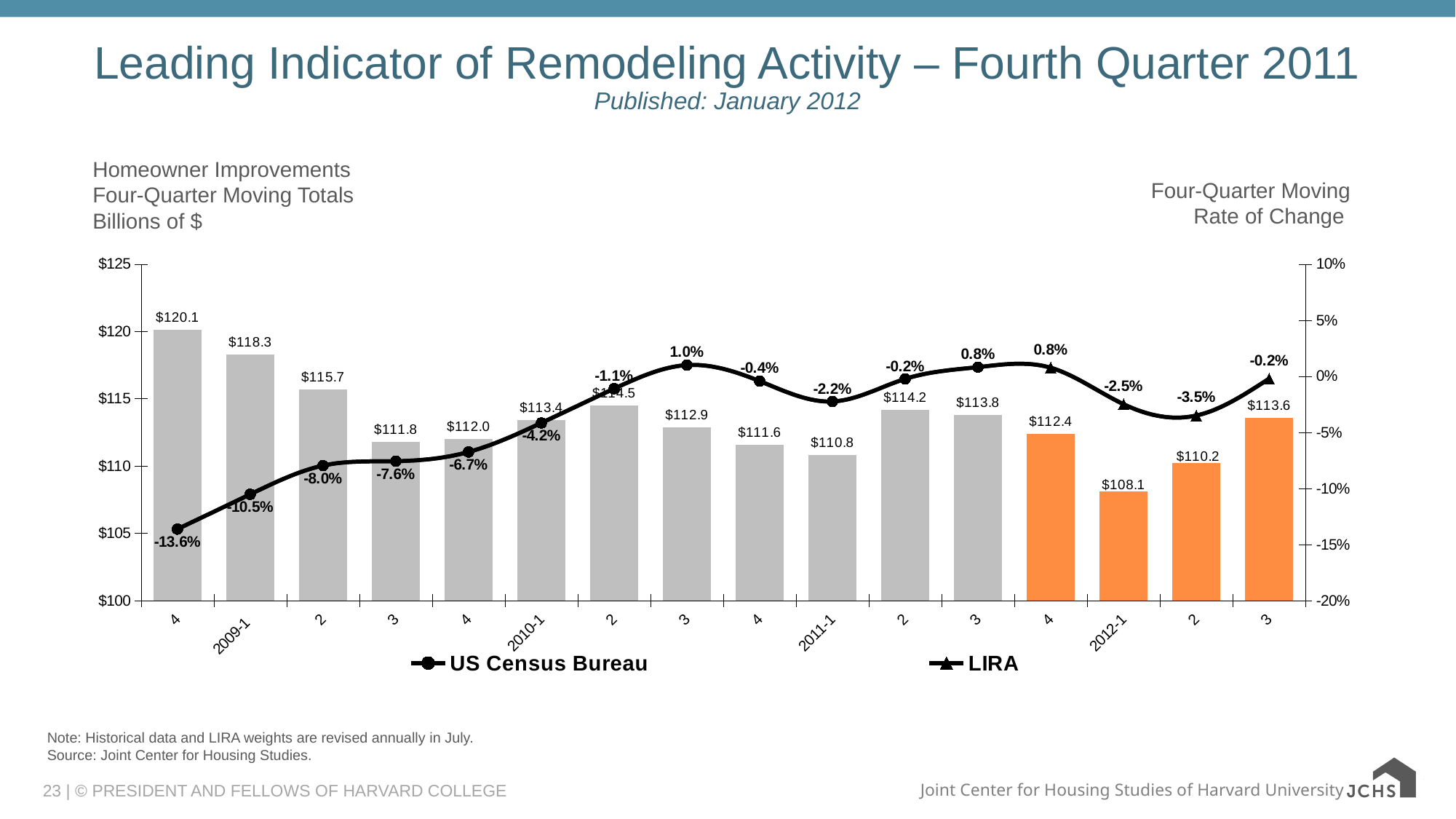
What is the four-quarter moving rate of change for 2011-1? -2.2% What is the four-quarter moving rate of change for the last quarter shown, 2012-3? -0.2% Which has the larger four-quarter moving total, 2011-3 or 2011-4? 2011-3 What is the lowest four-quarter moving rate of change shown on the line? -13.6% How many bars are plotted on the chart? 16 What is the highest four-quarter moving rate of change shown on the line? 1.0% How many series does the legend list? 2 What is the highest four-quarter moving total shown by the bars? $120.1 Which quarter has the lowest four-quarter moving total? 2012-1 ($108.1) By how much does the four-quarter moving total for 2011-2 exceed that for 2011-1? $3.4 What kind of chart is this? Combined bar and line chart What is the four-quarter moving total for 2009-1? $118.3